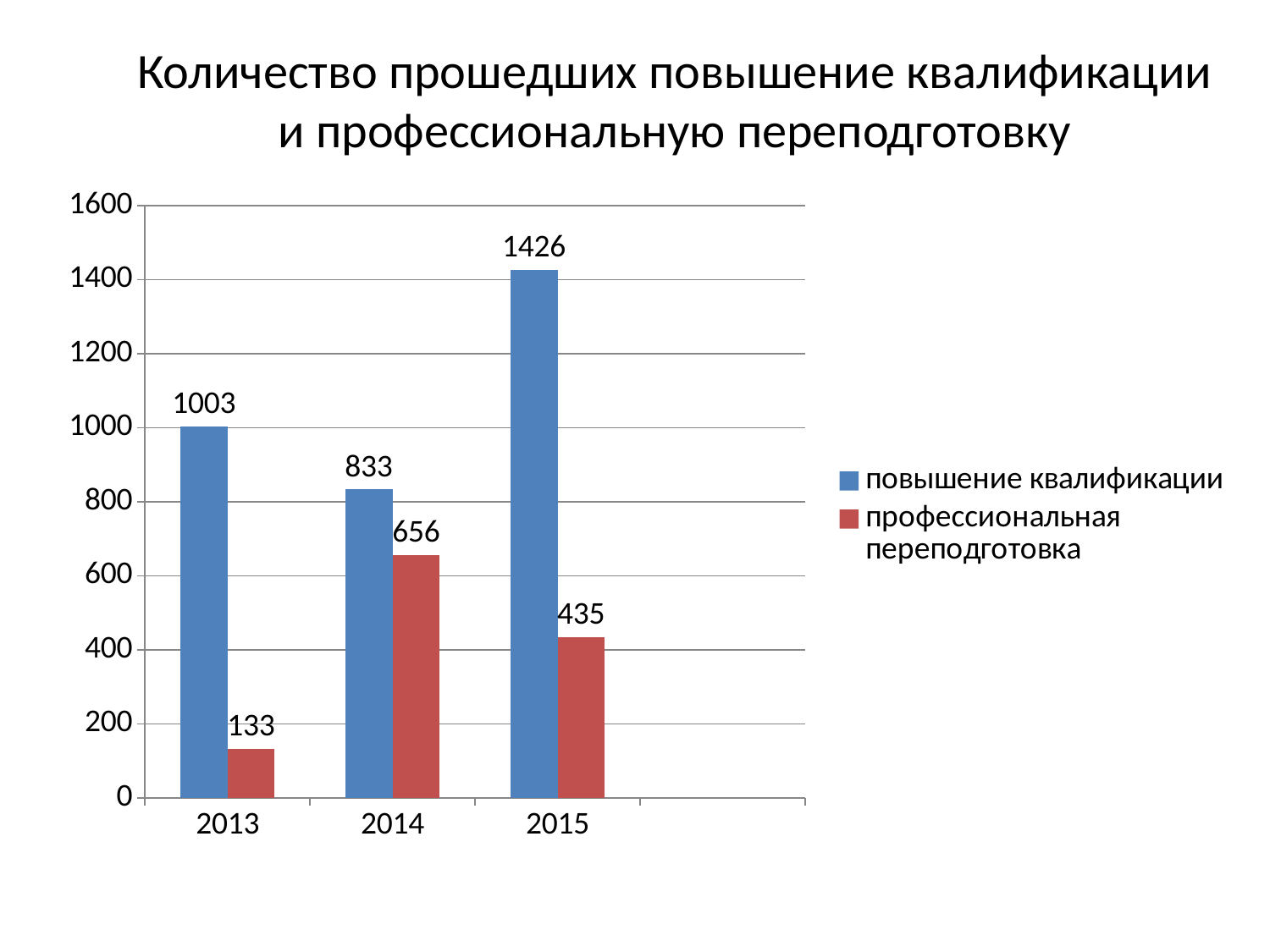
Which year has the highest value for повышение квалификации? 2015 Which is larger: повышение квалификации in 2013 or повышение квалификации in 2014? повышение квалификации in 2013 What is the value for профессиональная переподготовка in 2014? 656 What is the difference between повышение квалификации and профессиональная переподготовка in 2015? 991 What kind of chart is shown on the slide? bar chart Is the value for профессиональная переподготовка in 2015 greater or less than 400? greater What is the value for повышение квалификации in 2015? 1426 Which colour represents профессиональная переподготовка in the chart? red How many series does the legend list? 2 What is the value for профессиональная переподготовка in 2013? 133 How many years are shown on the x axis? 3 Which year has the lowest value for профессиональная переподготовка? 2013